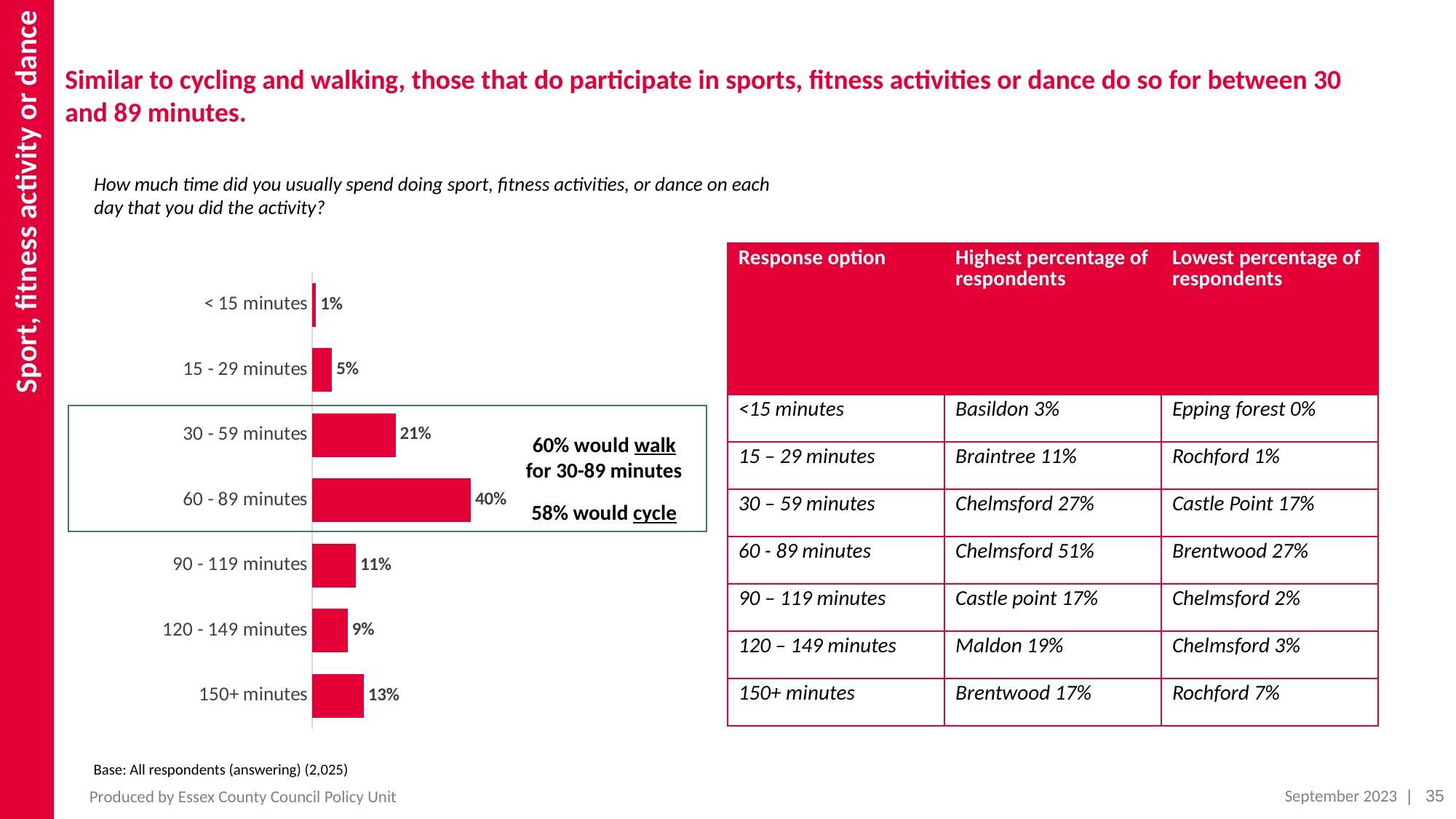
What is the base (number of respondents) stated for the chart? 2,025 How many time categories are shown in the bar chart? 7 What percentage of respondents spend 150+ minutes on the activity? 13% Which time category has the lowest percentage of respondents? < 15 minutes Which is larger: the percentage for 90 - 119 minutes or for 120 - 149 minutes? 90 - 119 minutes What percentage of respondents spend 60 - 89 minutes doing sport, fitness activities or dance? 40% What is the difference in percentage points between the 60 - 89 minutes and 30 - 59 minutes categories? 19 What percentage of respondents spend < 15 minutes on the activity? 1% What type of chart is used to show the time spent on sport, fitness activities or dance? Bar chart Which time category has the highest percentage of respondents? 60 - 89 minutes What is the combined percentage of respondents in the 30 - 59 minutes and 60 - 89 minutes categories? 61% What percentage of respondents spend 30 - 59 minutes on the activity? 21%